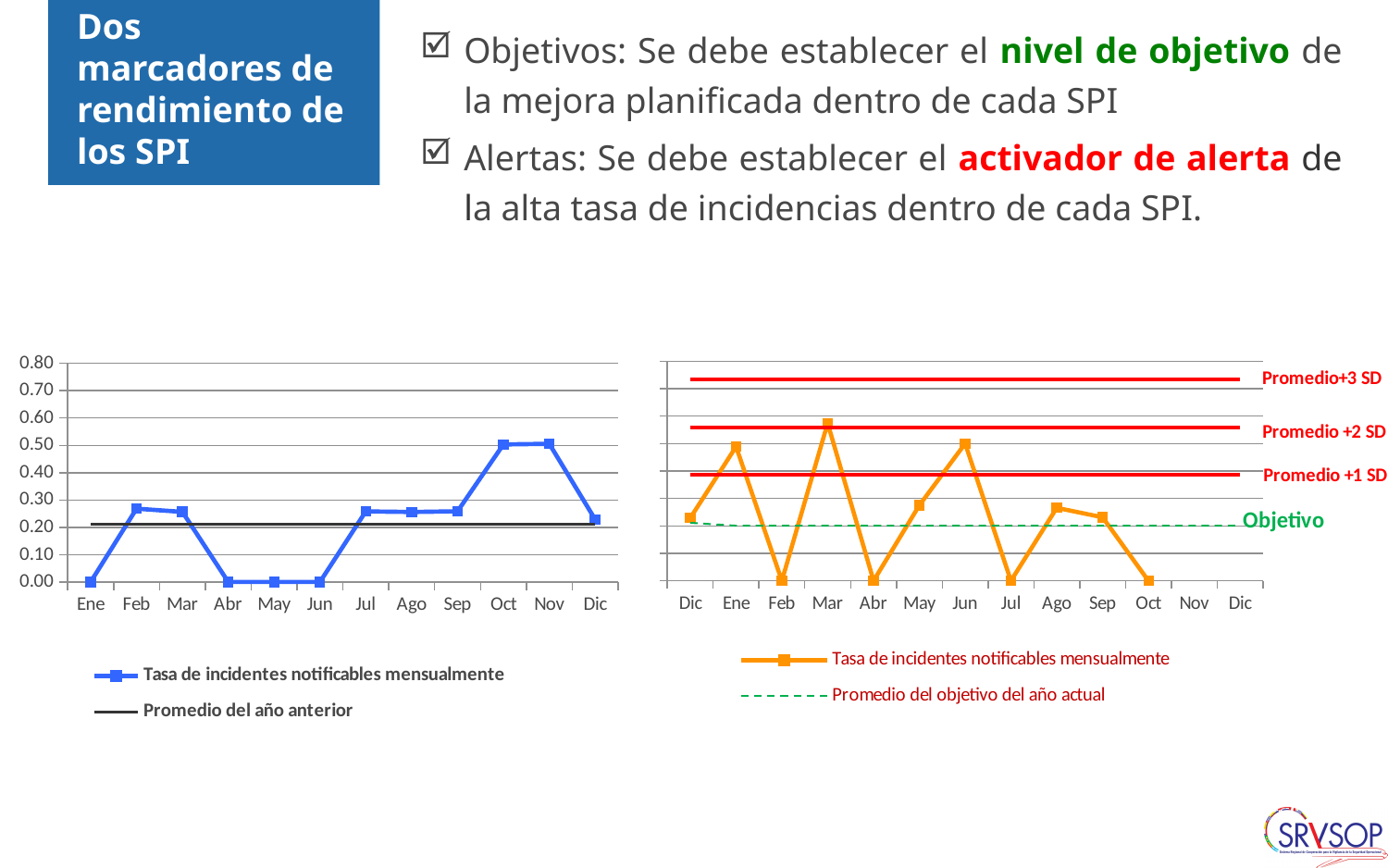
On the left chart, how many months are shown on the x axis? 12 How many series does the legend of the left chart list? 2 On the right chart, how many categories are shown on the x axis? 13 On the right chart, which month has the highest value of the orange series? Mar On the left chart, what is the value of 'Tasa de incidentes notificables mensualmente' for Ene? 0.00 On the right chart, which is larger, the value for Mar or the value for Ene? Mar What kind of chart is the left chart? line chart On the left chart, do the values rise or fall from Sep to Nov? rise On the left chart, which is larger, the value for Oct or the value for Mar? Oct On the left chart, is the value for Feb greater or less than 0.20? greater On the right chart, what is the label of the green dashed line? Objetivo On the left chart, is the value for Oct greater or less than 0.40? greater